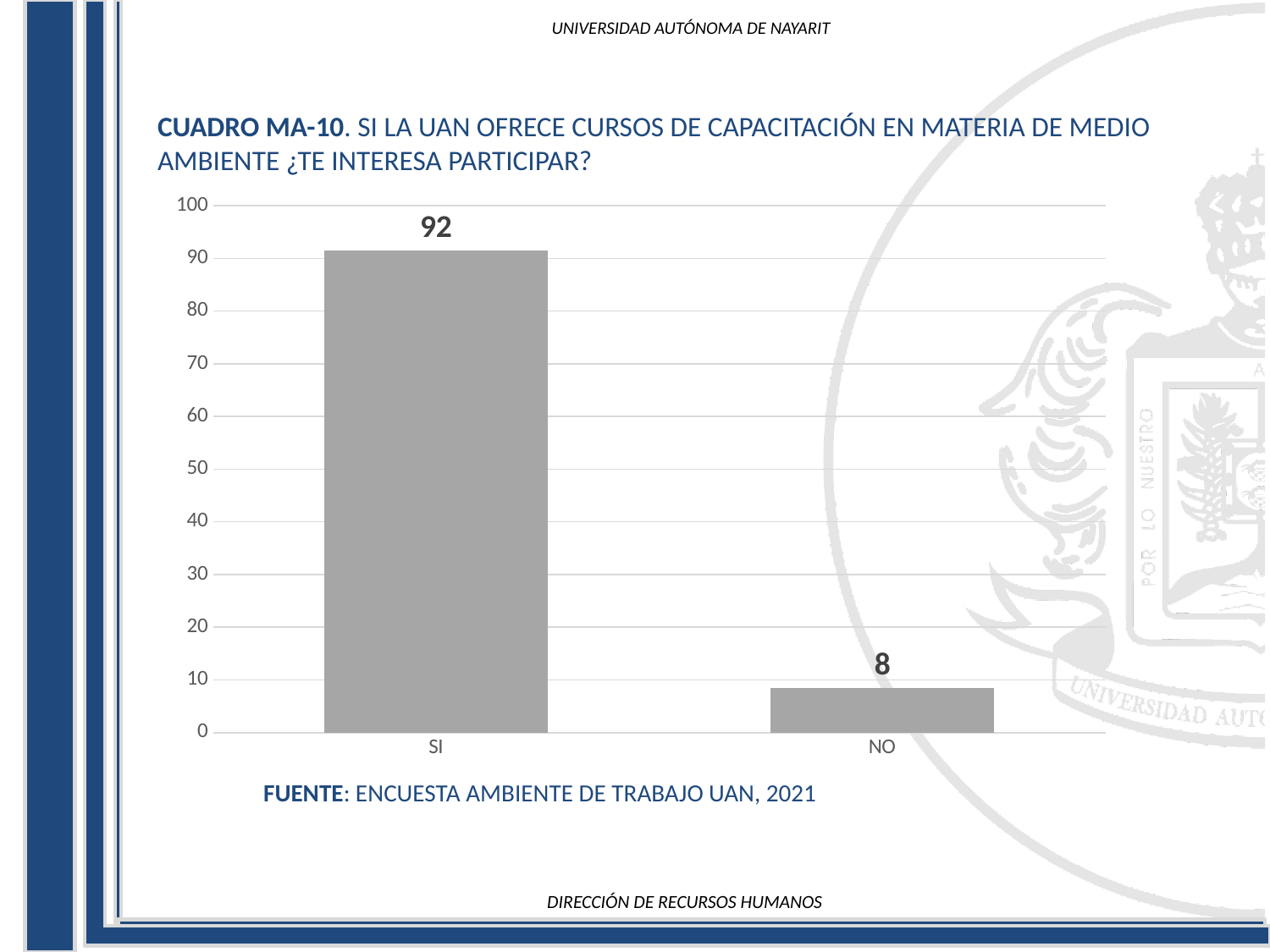
Is the value for SI greater or less than 50? greater What is the highest value shown on the y axis? 100 Which category has the lowest value? NO What is the value for SI? 92 What is the difference between the values for SI and NO? 84 What is the source cited below the chart? ENCUESTA AMBIENTE DE TRABAJO UAN, 2021 Is the value for NO greater or less than 10? less How many categories are shown on the x axis? 2 What kind of chart is shown on the slide? bar chart Which category has the highest value? SI What is the value for NO? 8 Which is larger, the value for SI or the value for NO? SI